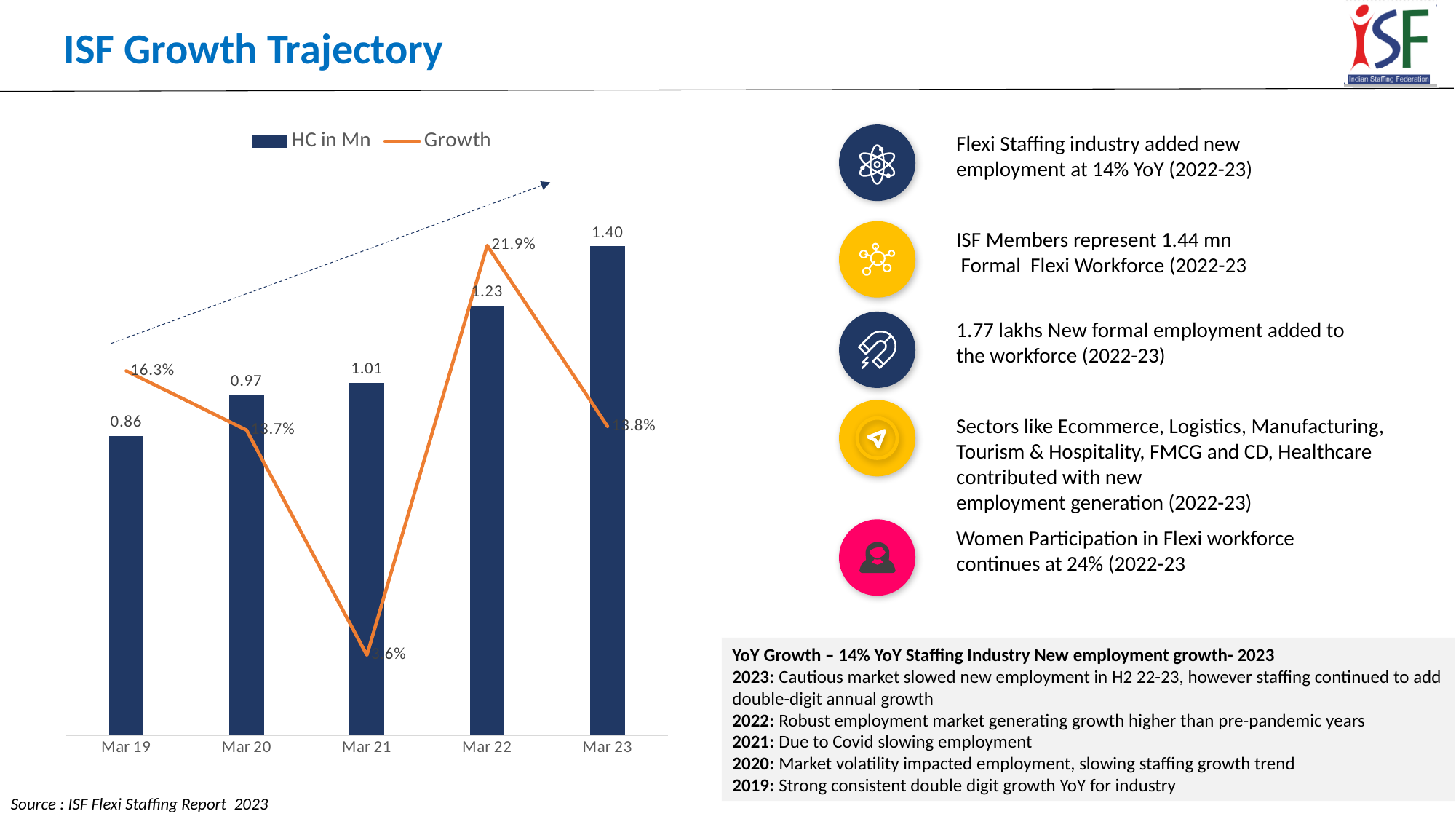
What is the HC in Mn value for Mar 19? 0.86 How many series does the chart legend list? 2 Do the HC in Mn bar values rise or fall from Mar 19 to Mar 23? rise How many periods are shown on the x axis of the chart? 5 Which is larger, the HC in Mn value for Mar 20 or for Mar 21? Mar 21 What is the difference in HC in Mn between Mar 23 and Mar 22? 0.17 What is the HC in Mn value for Mar 21? 1.01 What is the HC in Mn value for Mar 23? 1.40 What is the Growth value for Mar 19? 16.3% What is the Growth value for Mar 22? 21.9% Which period has the highest HC in Mn value? Mar 23 Which period has the lowest HC in Mn value? Mar 19